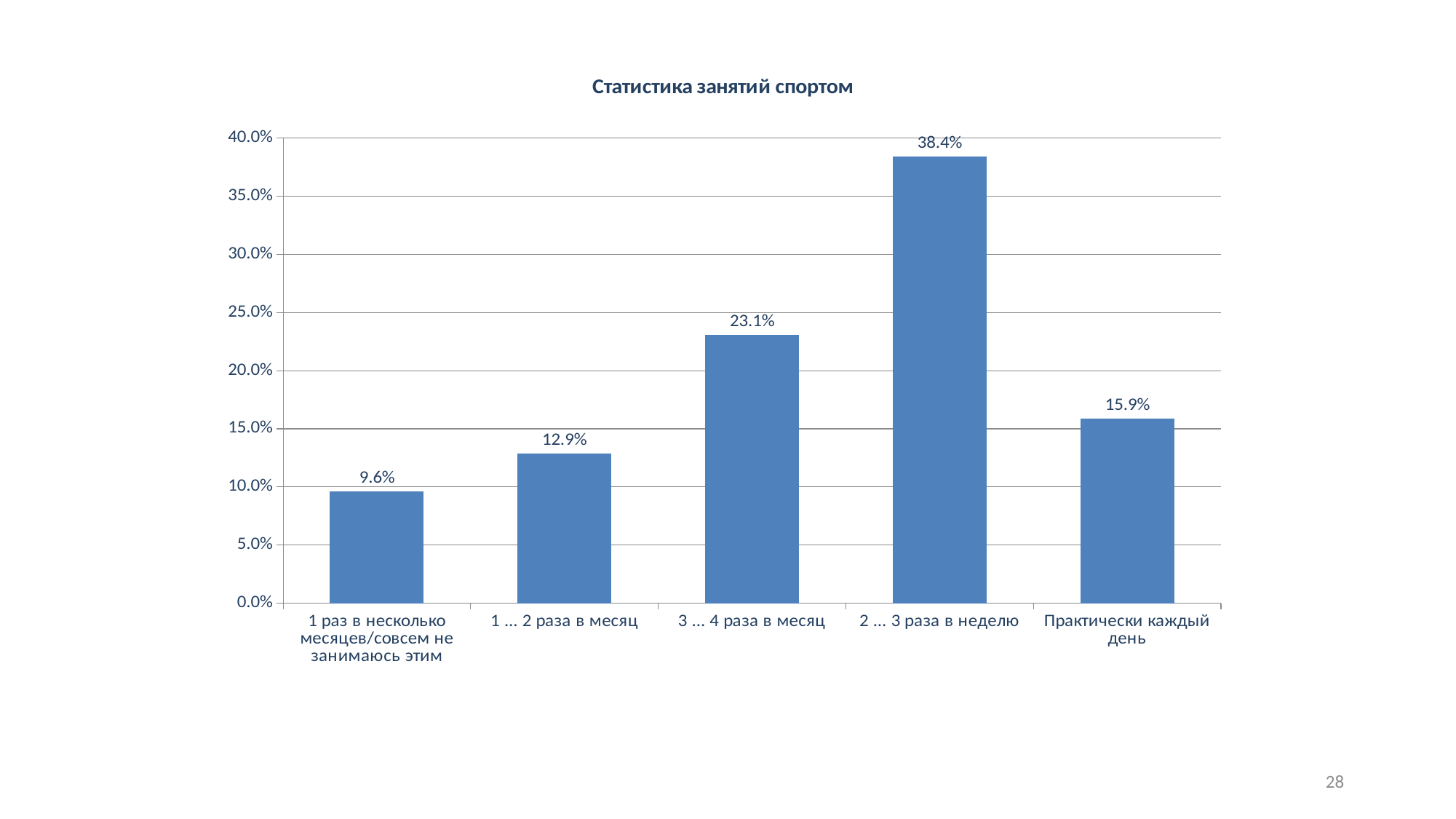
What is the difference between the values for "Практически каждый день" and "1 … 2 раза в месяц"? 3.0% How many categories are shown on the x axis? 5 What is the title of the chart? Статистика занятий спортом What is the value for "Практически каждый день"? 15.9% Which category has the lowest value? 1 раз в несколько месяцев/совсем не занимаюсь этим Which is larger: the value for "3 … 4 раза в месяц" or the value for "Практически каждый день"? 3 … 4 раза в месяц What kind of chart is shown on the slide? bar chart Is the value for "3 … 4 раза в месяц" greater or less than 20.0%? greater What is the value for "1 … 2 раза в месяц"? 12.9% What is the value for "2 … 3 раза в неделю"? 38.4% What is the difference between the values for "2 … 3 раза в неделю" and "3 … 4 раза в месяц"? 15.3% Which category has the highest value? 2 … 3 раза в неделю